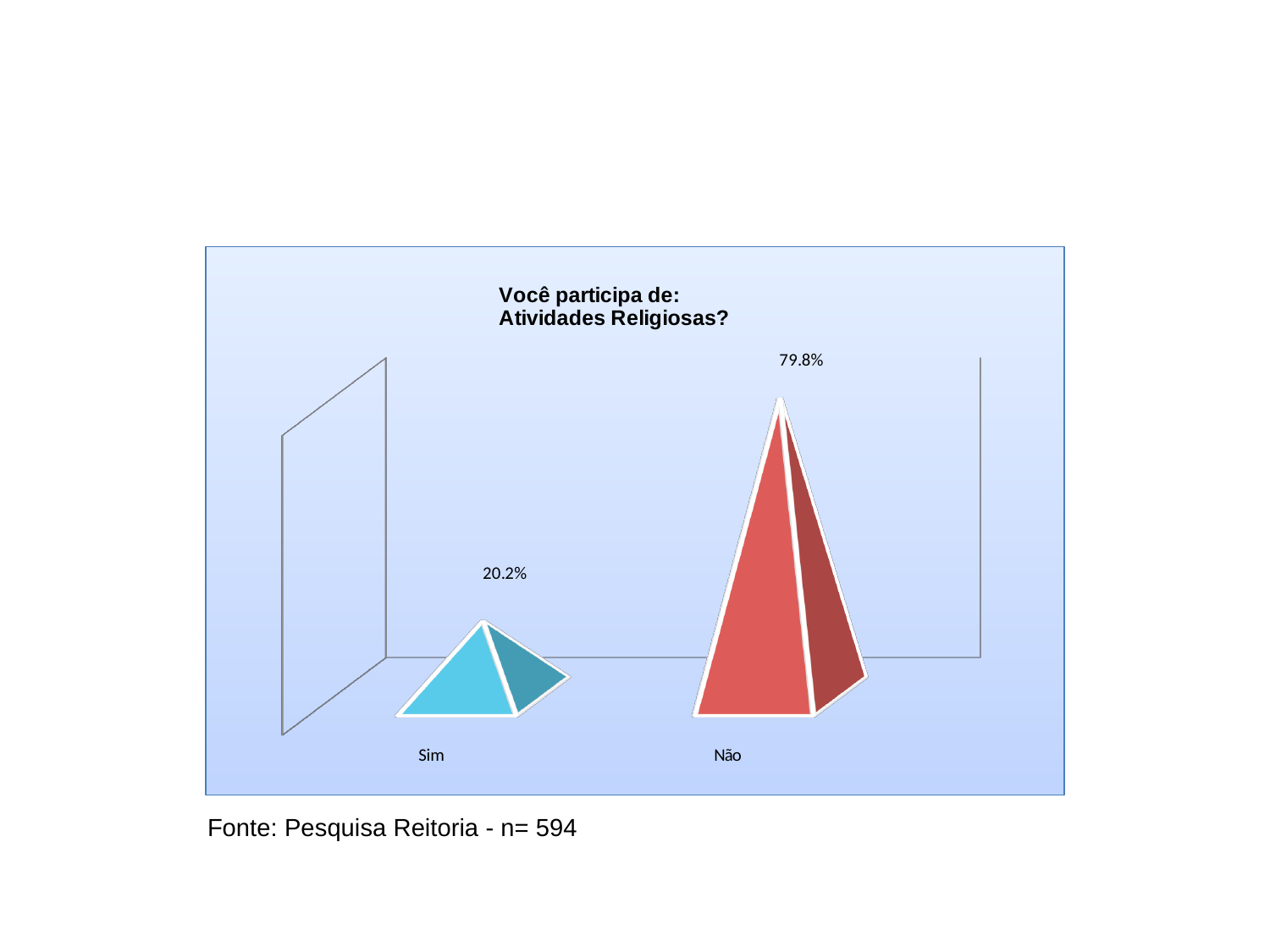
What is the difference between the values for "Não" and "Sim"? 59.6% What kind of chart is shown on the slide? Bar chart What is the value for "Sim"? 20.2% What is the title of the chart? Você participa de: Atividades Religiosas? Which category has the lowest value? Sim Which is larger, the value for "Sim" or the value for "Não"? Não What colour is the bar for "Não"? Red Which category has the highest value? Não How many categories are shown in the chart? 2 What is the total of the two values shown in the chart? 100% What is the value for "Não"? 79.8%